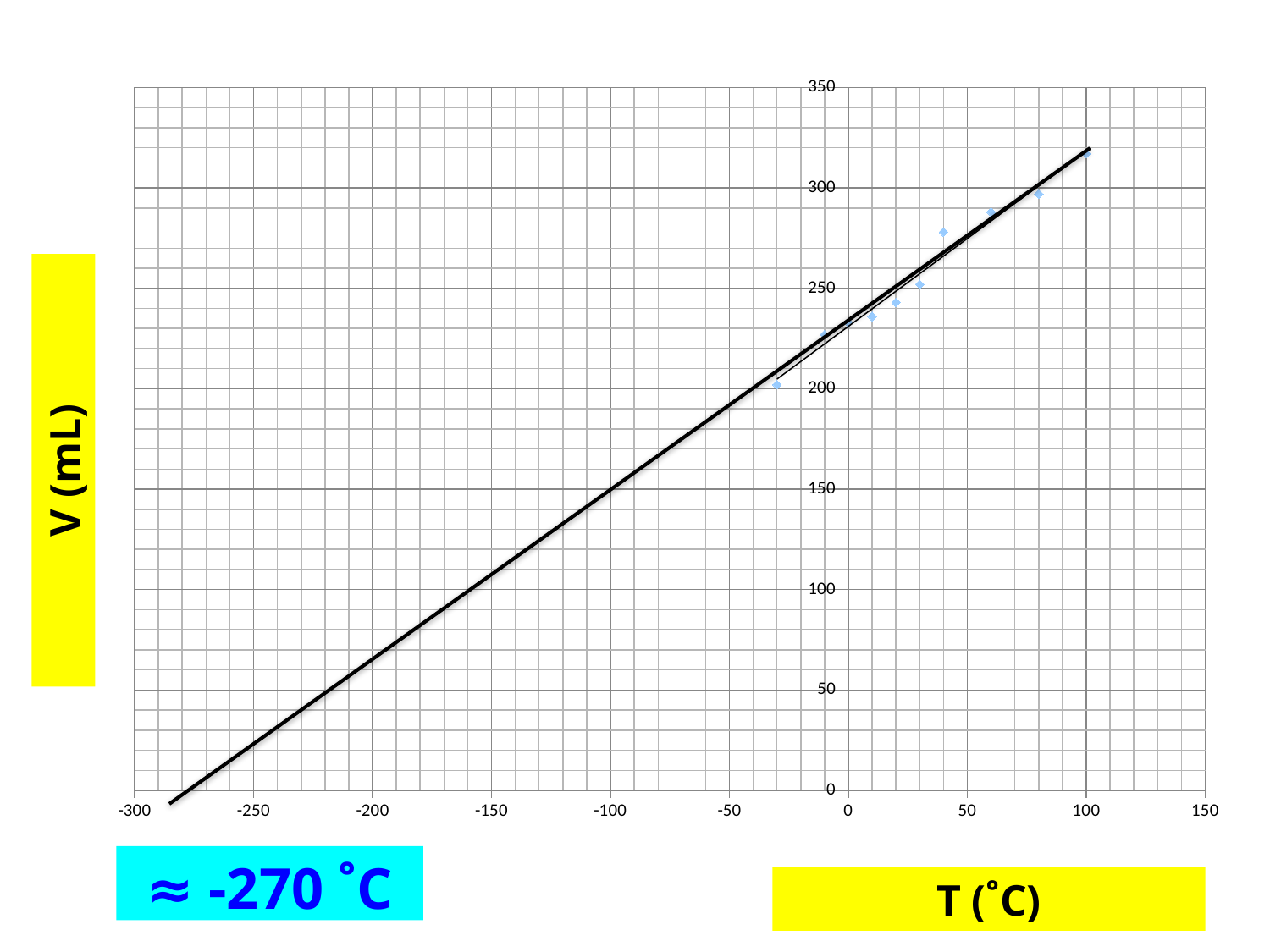
Is the value of V for the data point at T = 0 greater or less than 200? greater Which data point has the highest V value, the one at T = 100 or the one at T = -30? T = 100 Is the value of V for the data point at T = 100 greater or less than 300? greater What is the label on the y axis? V (mL) What kind of chart is shown on the slide? scatter chart Do the plotted values of V rise or fall as T increases along the x axis? rise Is the value of V for the data point at T = -30 greater or less than 250? less At which temperature does the data point with the lowest V value occur? -30 At which temperature does the data point with the highest V value occur? 100 What temperature does the annotation say the extrapolated line reaches V = 0 at? ≈ -270 °C